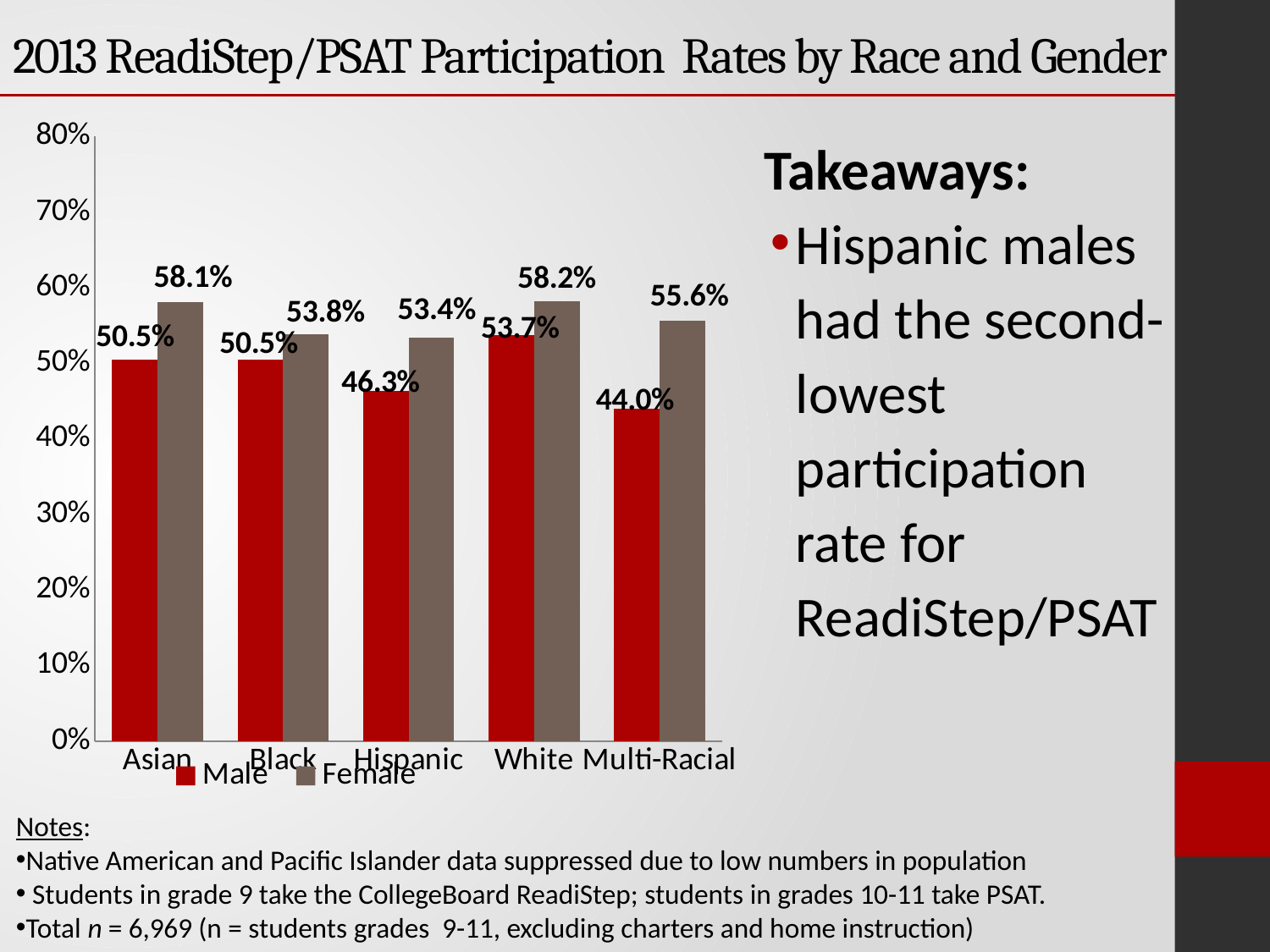
Which race category has the lowest Male participation rate? Multi-Racial How many series does the legend list? 2 What is the difference between the Female and Male participation rates for Black students? 3.3% How many race categories are shown on the x axis? 5 What is the Male participation rate for Hispanic students? 46.3% What type of chart is shown on the slide? bar chart What is the Female participation rate for Asian students? 58.1% Is the Female participation rate for Hispanic students higher or lower than the Male rate for Hispanic students? higher Which race category has the highest Male participation rate? White What is the Male participation rate for White students? 53.7% What is the Female participation rate for Multi-Racial students? 55.6% What is the difference between the Female and Male participation rates for Multi-Racial students? 11.6%